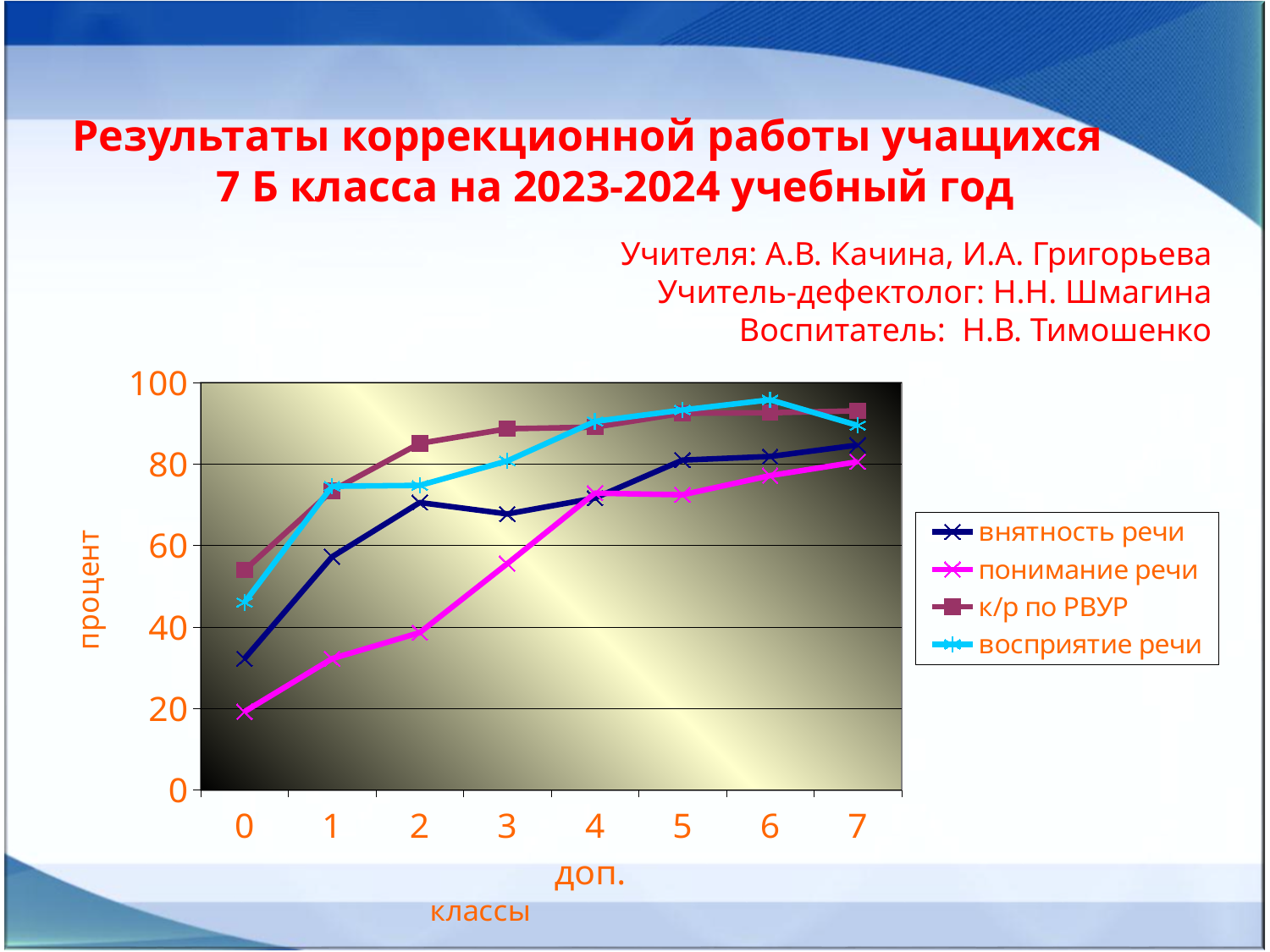
At x = 3, which is larger: внятность речи or понимание речи? внятность речи Is the value for восприятие речи at x = 0 greater or less than 40? greater Does the понимание речи series generally rise or fall from x = 0 to x = 7? rise How many points are marked along the x axis of the chart? 8 At x = 0, which series has the lowest value? понимание речи What is the label on the vertical axis of the chart? процент What kind of chart is shown on the slide? line chart Is the value for к/р по РВУР at x = 2 greater or less than 80? greater Is the value for внятность речи at x = 0 greater or less than 40? less How many series does the legend list? 4 At x = 0, which series has the highest value? к/р по РВУР